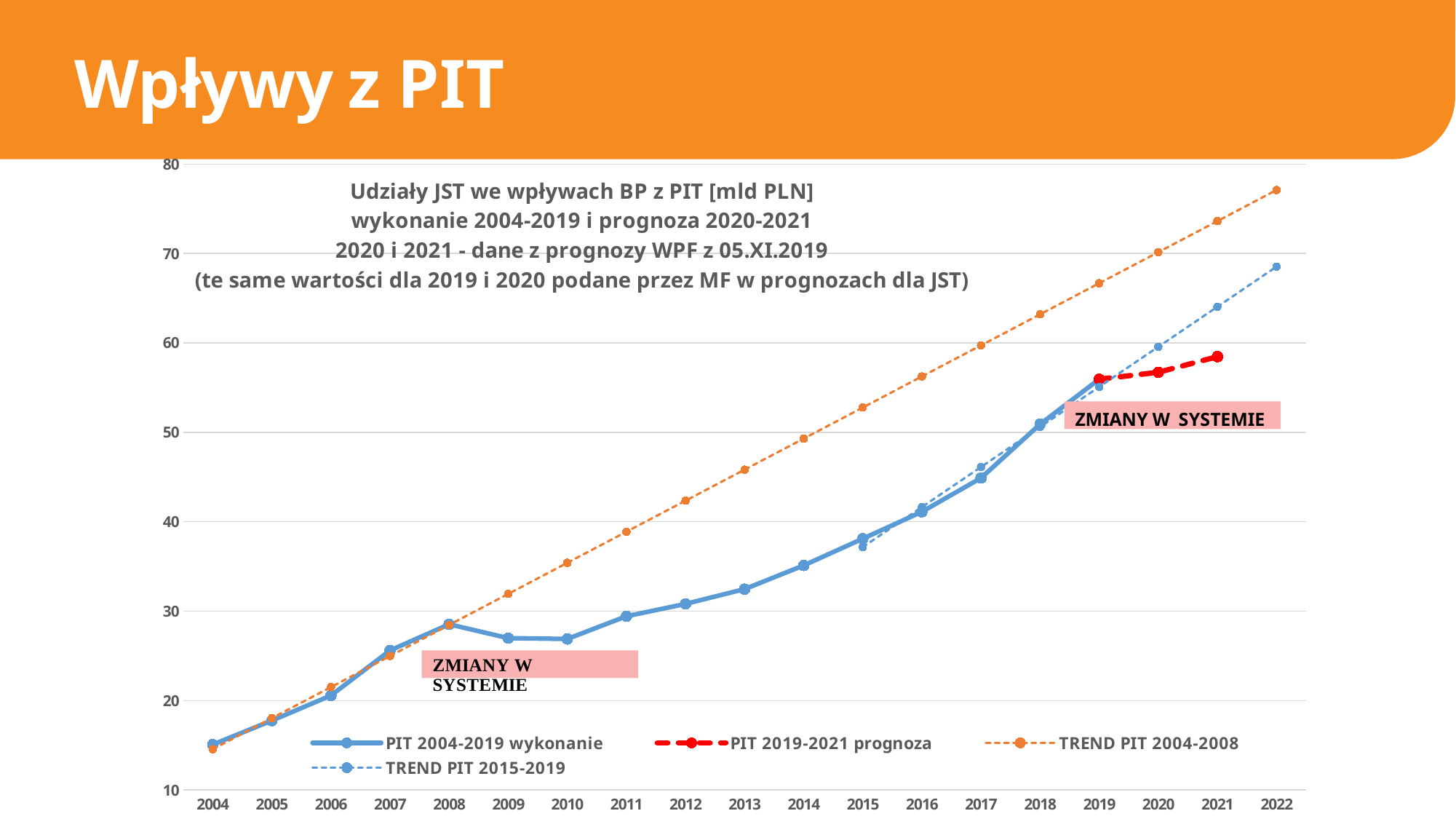
Is the value of TREND PIT 2004-2008 in 2022 greater or less than 70? greater Is the value of PIT 2019-2021 prognoza in 2021 greater or less than 60? less In which year does the PIT 2004-2019 wykonanie series have its lowest value? 2004 What text appears in the two pink annotation boxes on the chart? ZMIANY W SYSTEMIE How many years are shown on the x axis? 19 In which year does the PIT 2004-2019 wykonanie series reach its highest value? 2019 What kind of chart is shown on the slide? line chart Is the value of PIT 2004-2019 wykonanie in 2016 greater or less than 40? greater In 2021, which is higher: TREND PIT 2004-2008 or PIT 2019-2021 prognoza? TREND PIT 2004-2008 Does the PIT 2004-2019 wykonanie line rise or fall from 2008 to 2009? fall How many series does the legend list? 4